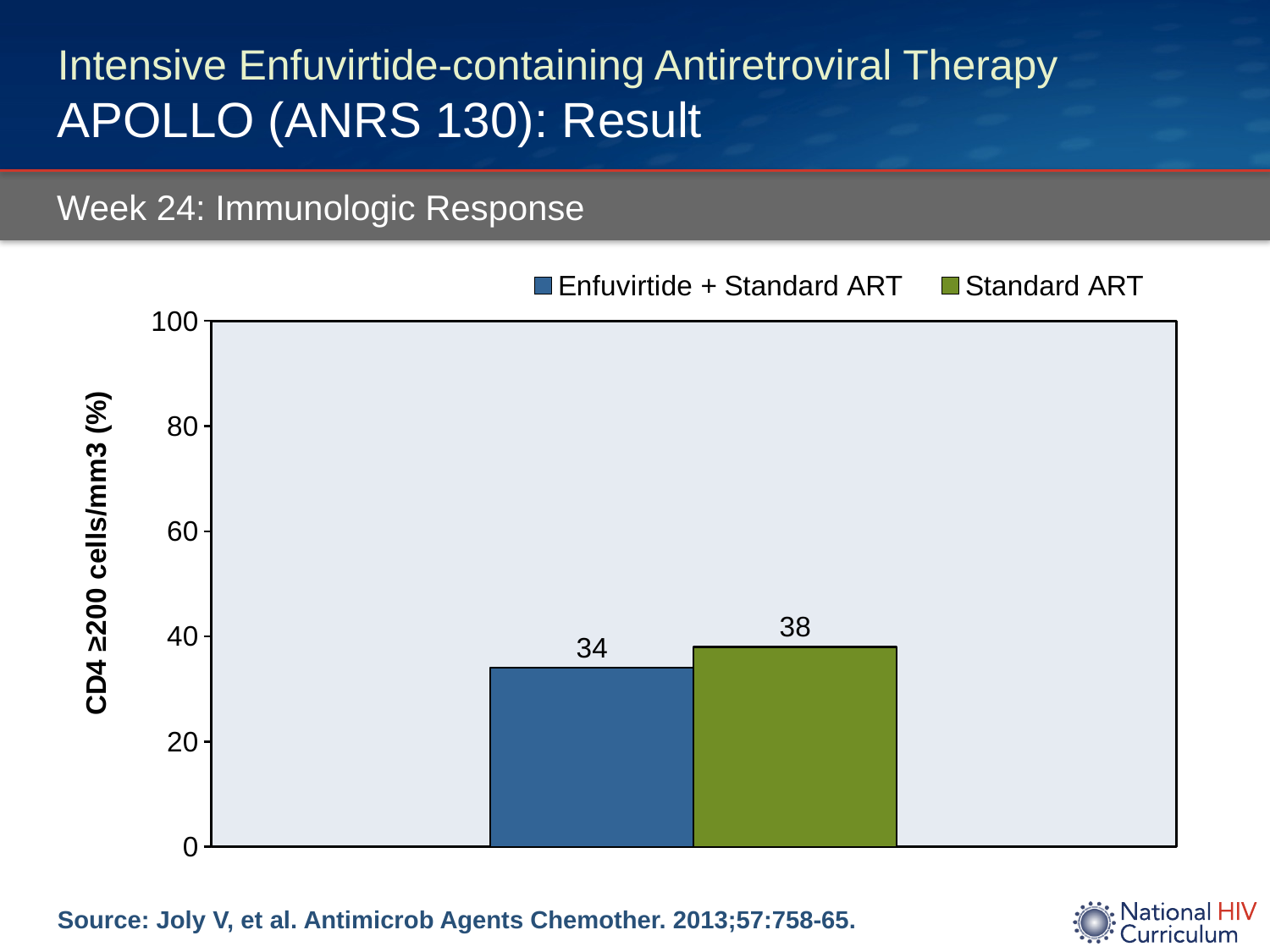
Is the value for Enfuvirtide + Standard ART greater or less than 20? greater What colour is the bar for Standard ART? green What is the label of the y axis? CD4 ≥200 cells/mm3 (%) What is the value for Standard ART? 38 How many series does the legend list? 2 Is the value for Standard ART greater or less than 40? less Which series has the lowest value? Enfuvirtide + Standard ART How many bars are plotted in the chart? 2 What is the value for Enfuvirtide + Standard ART? 34 What kind of chart is shown? bar chart What is the difference between the Standard ART value and the Enfuvirtide + Standard ART value? 4 Which series has the higher value, Enfuvirtide + Standard ART or Standard ART? Standard ART